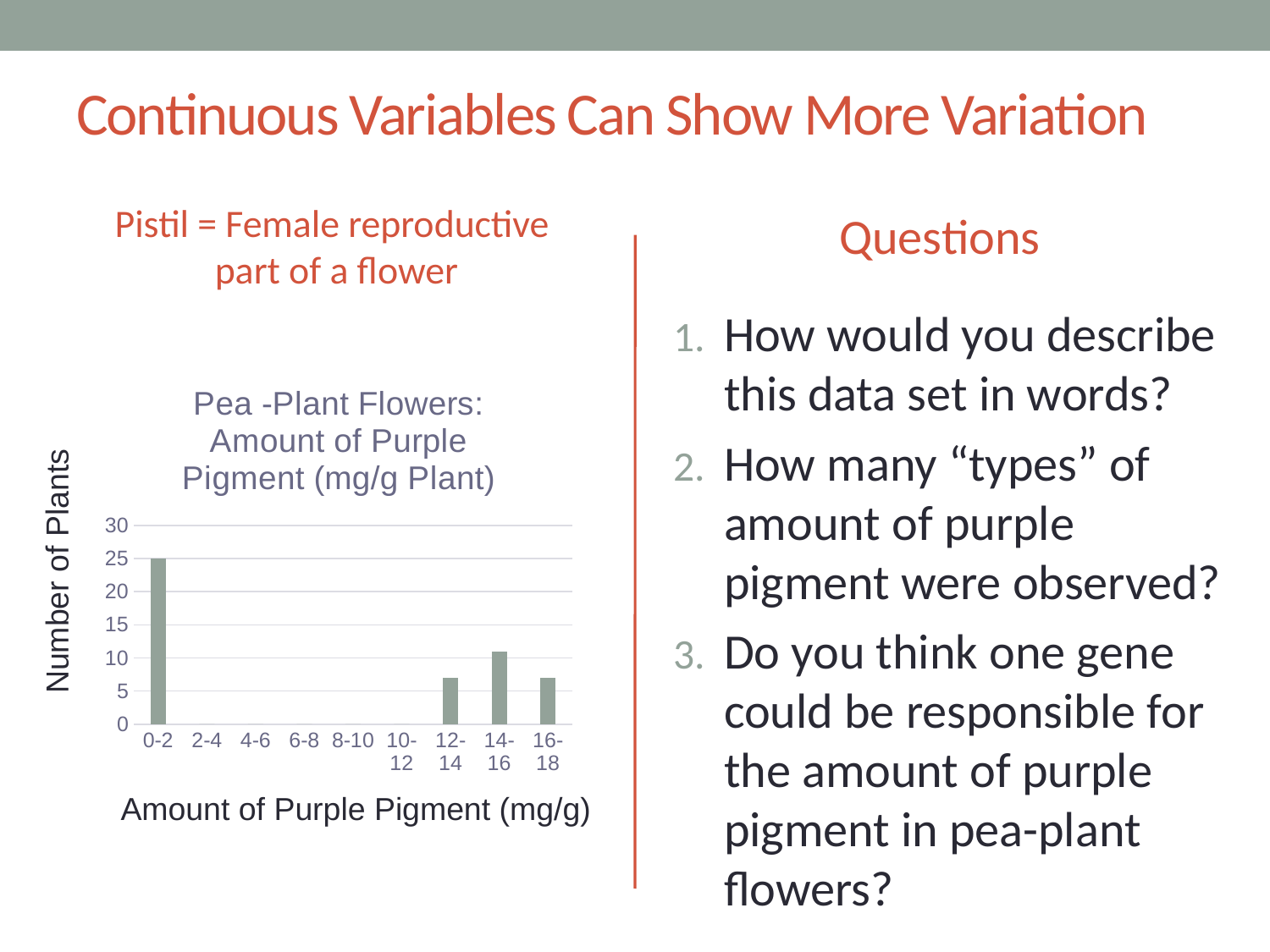
Is the number of plants for the 16-18 category greater or less than 5? greater How many categories on the chart have no bar (zero plants)? 5 Which pigment-amount category has the highest number of plants? 0-2 How many pigment-amount categories are shown on the x axis of the chart? 9 Which has more plants, the 12-14 category or the 14-16 category? 14-16 Which has more plants, the 0-2 category or the 14-16 category? 0-2 What is the label on the vertical axis of the chart? Number of Plants What is the label on the horizontal axis of the chart? Amount of Purple Pigment (mg/g) Is the number of plants for the 12-14 category greater or less than 10? less What is the number of plants for the 0-2 category? 25 What kind of chart is shown on the slide? bar chart Is the number of plants for the 14-16 category greater or less than 15? less